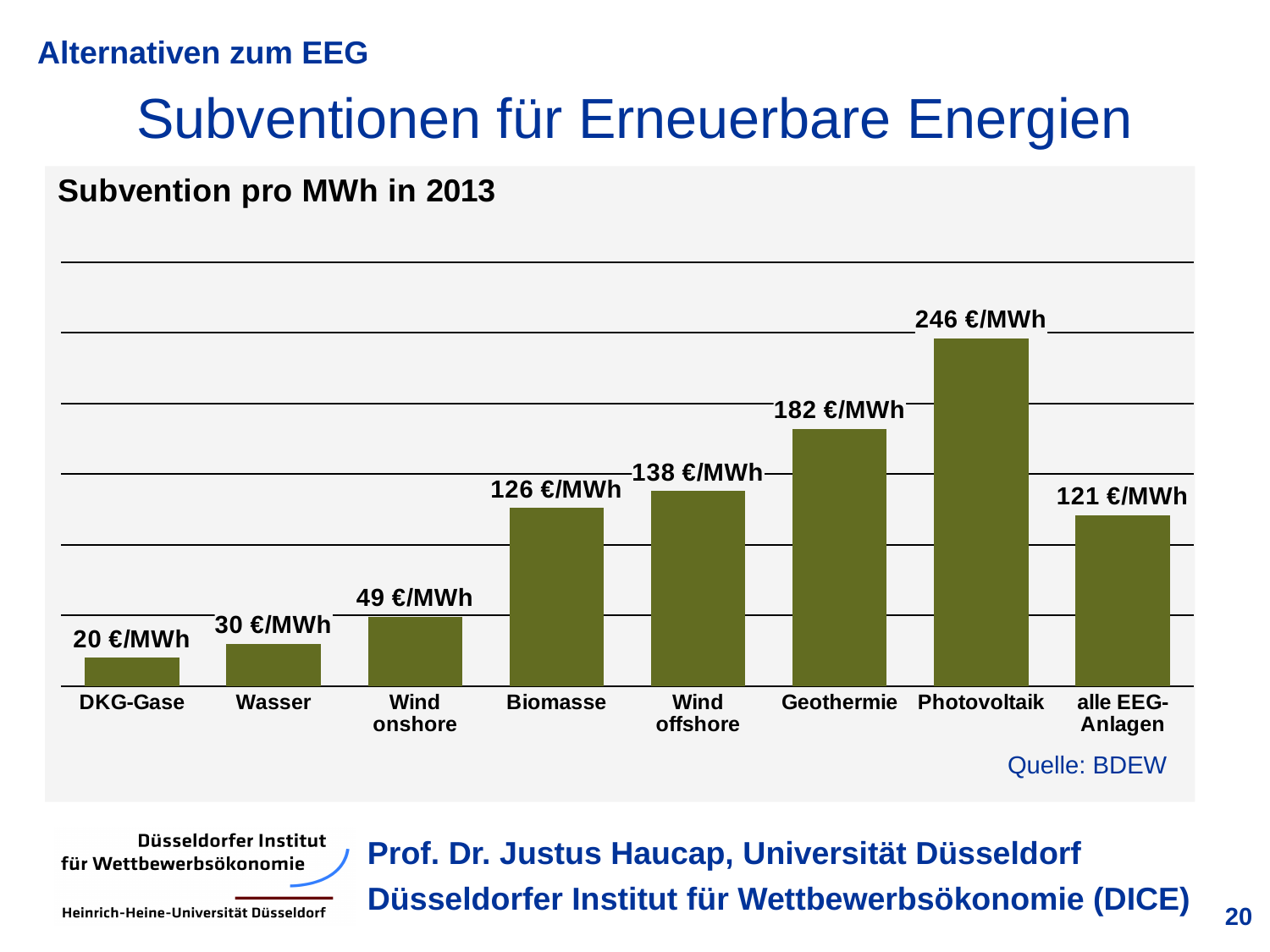
What is the difference between the subsidy for Wind offshore and Biomasse? 12 €/MWh Which category has the lowest subsidy per MWh? DKG-Gase How many categories are shown in the chart? 8 What is the difference between the subsidy for Photovoltaik and Geothermie? 64 €/MWh What kind of chart is shown on the slide? Bar chart What is the subsidy per MWh for Photovoltaik? 246 €/MWh What is the source cited for the chart? BDEW What is the subsidy per MWh for alle EEG-Anlagen? 121 €/MWh Which category has the highest subsidy per MWh? Photovoltaik What is the subsidy per MWh for Wind onshore? 49 €/MWh Which has a larger subsidy per MWh, Wasser or Wind onshore? Wind onshore Which has a larger subsidy per MWh, Geothermie or Biomasse? Geothermie